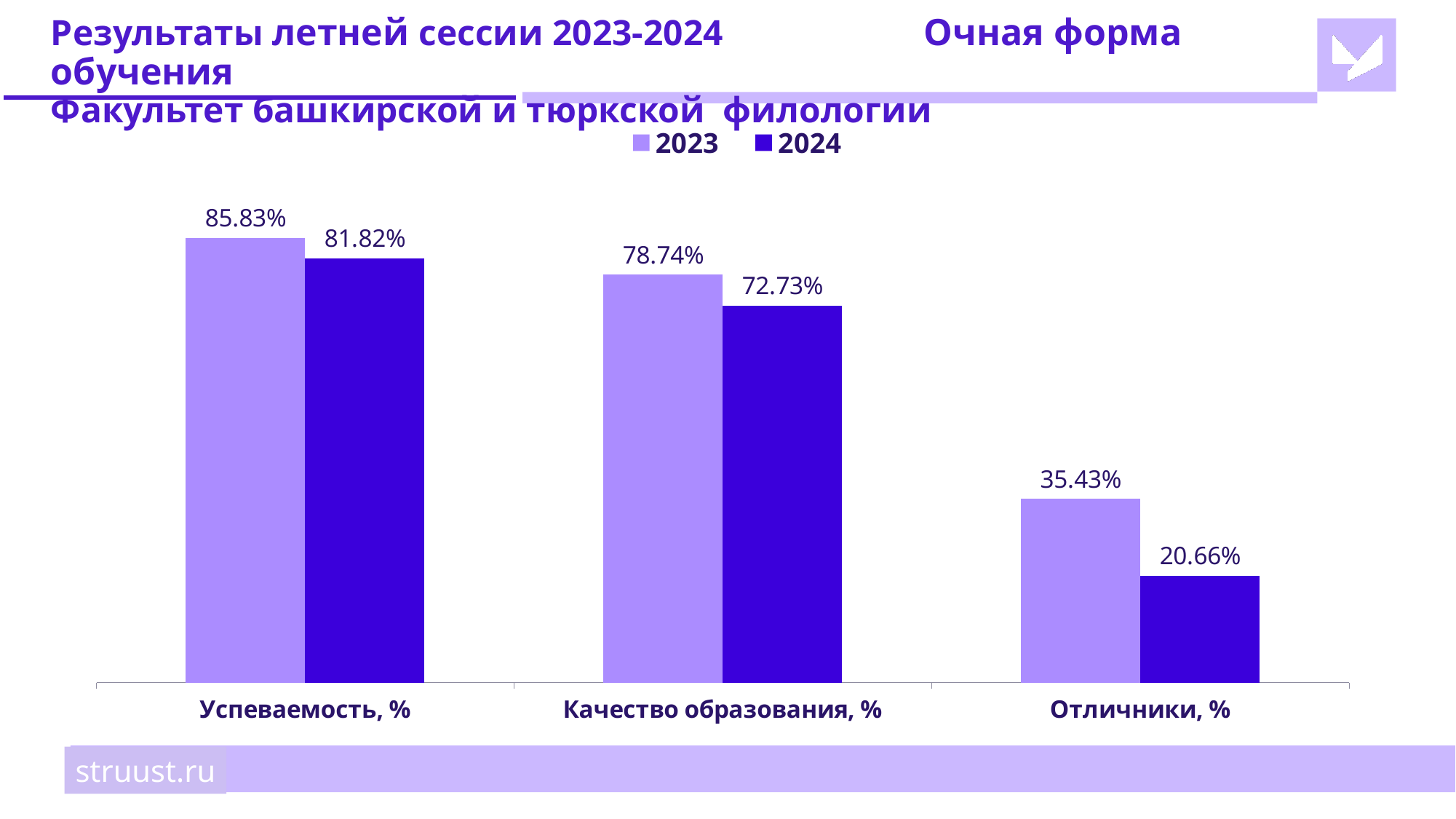
Which is larger for Качество образования, %: the 2023 value or the 2024 value? 2023 What is the difference between the 2023 and 2024 values for Успеваемость, %? 4.01% How many categories are shown on the x axis? 3 How many series does the legend list? 2 Which category has the highest 2024 value? Успеваемость, % What is the 2024 value for Качество образования, %? 72.73% What is the 2023 value for Отличники, %? 35.43% What kind of chart is shown on the slide? Bar chart What is the 2023 value for Успеваемость, %? 85.83% What is the 2024 value for Отличники, %? 20.66% Which category has the lowest 2023 value? Отличники, % What is the difference between the 2023 and 2024 values for Отличники, %? 14.77%